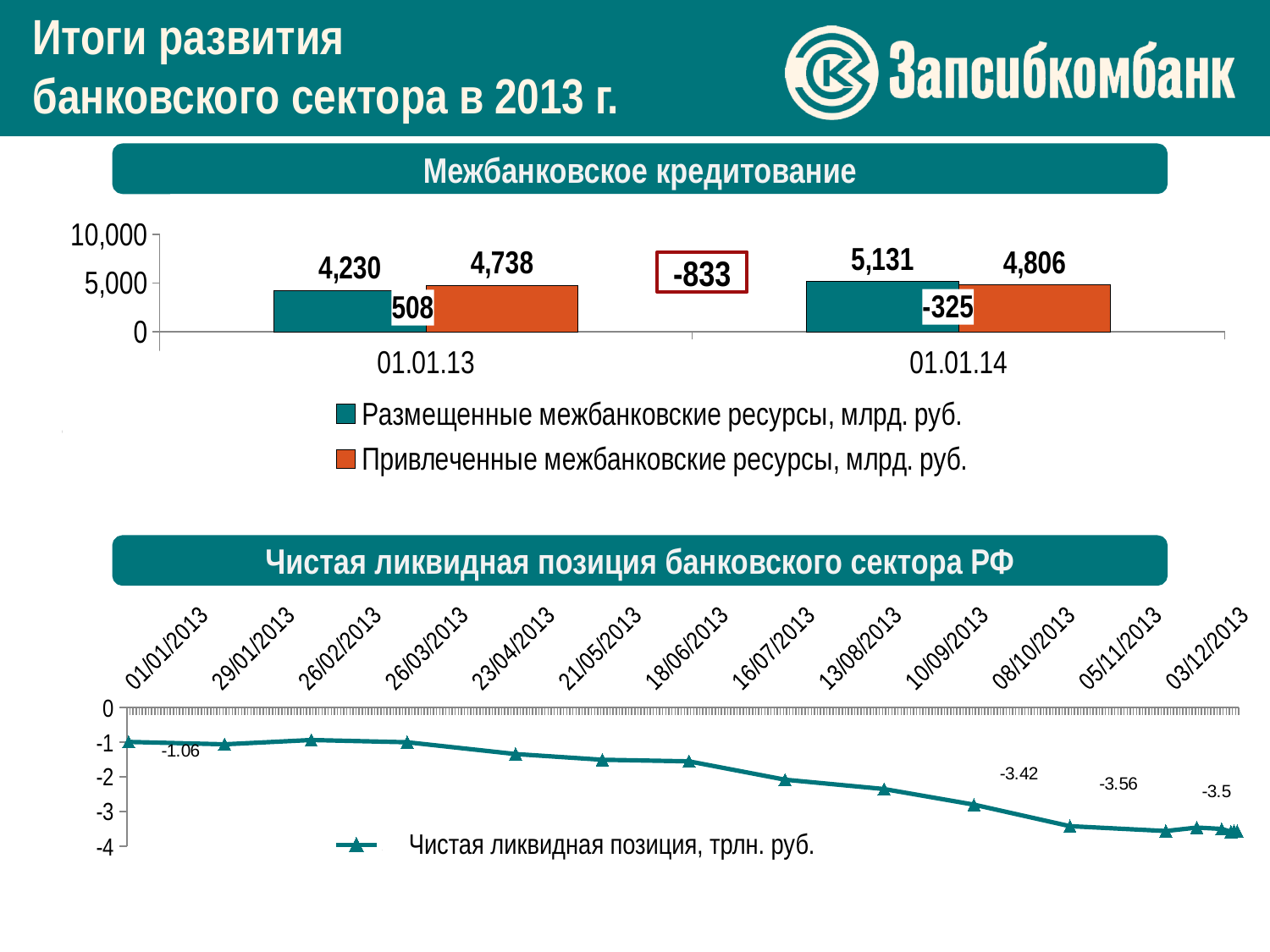
How many series does the legend of the chart 'Межбанковское кредитование' list? 2 What kind of chart is 'Чистая ликвидная позиция банковского сектора РФ'? Line chart In the chart 'Межбанковское кредитование', what is the value of 'Привлеченные межбанковские ресурсы' on 01.01.14? 4,806 In the chart 'Межбанковское кредитование', what is the value of 'Размещенные межбанковские ресурсы' on 01.01.13? 4,230 In the chart 'Чистая ликвидная позиция банковского сектора РФ', is the value at 26/02/2013 greater or less than -2? greater In the chart 'Межбанковское кредитование', what value is shown in the red-outlined box between the two date groups? -833 In the chart 'Межбанковское кредитование', on 01.01.14 which is larger: 'Размещенные' or 'Привлеченные' межбанковские ресурсы? Размещенные межбанковские ресурсы In the chart 'Межбанковское кредитование', by how much did 'Размещенные межбанковские ресурсы' increase from 01.01.13 to 01.01.14? 901 What kind of chart is 'Межбанковское кредитование'? Bar chart In the chart 'Чистая ликвидная позиция банковского сектора РФ', does the line generally rise or fall over the year? Fall In the chart 'Межбанковское кредитование', what is the value of 'Размещенные межбанковские ресурсы' on 01.01.14? 5,131